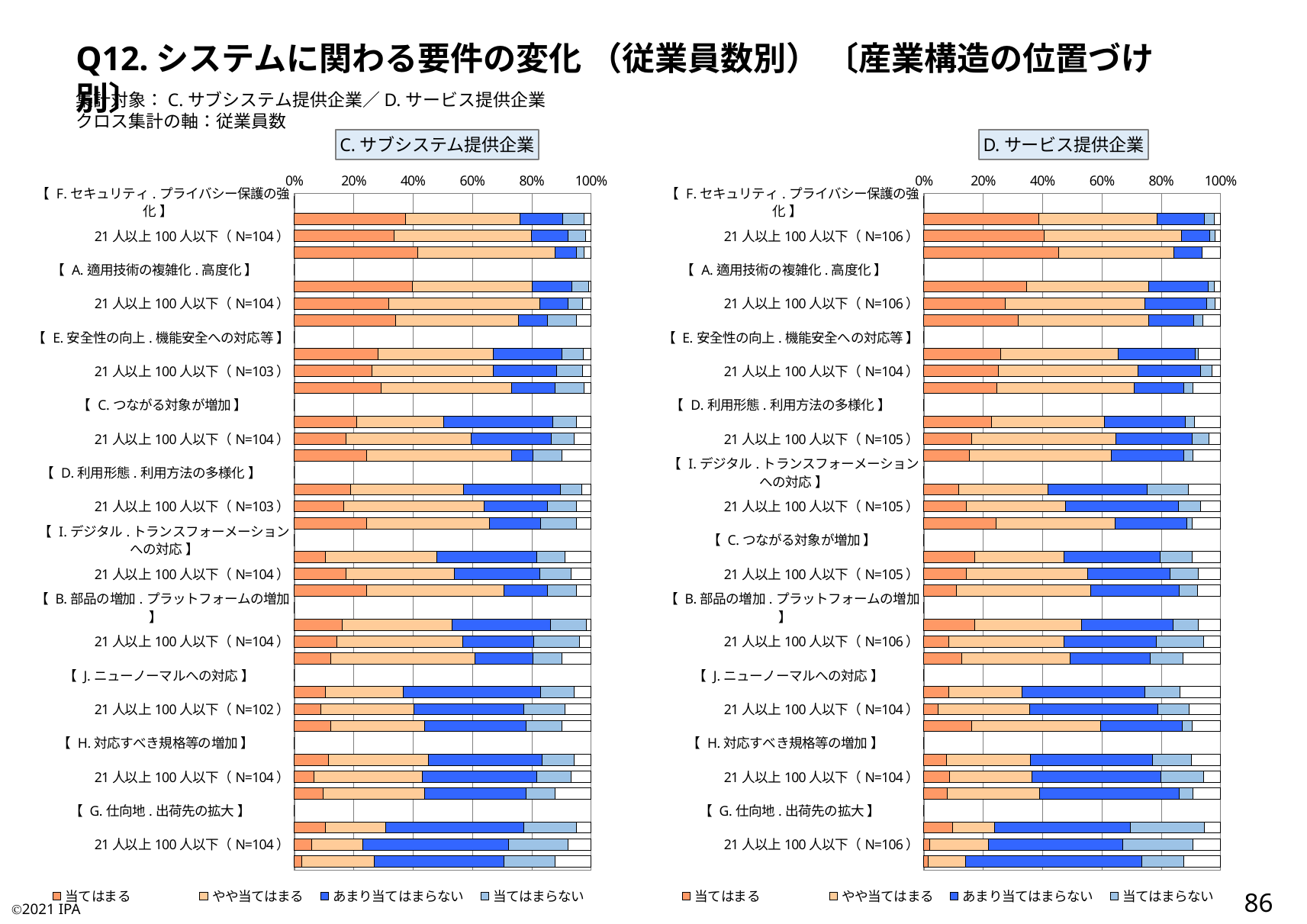
In the left chart (C. サブシステム提供企業), is the 当てはまる share for 21人以上100人以下 (N=104) under A. 適用技術の複雑化.高度化 greater or less than 40%? less In the left chart (C. サブシステム提供企業), is the 当てはまる share for 21人以上100人以下 (N=104) under G. 仕向地.出荷先の拡大 greater or less than 20%? less How many requirement groups (bracketed headings) are listed on the left chart (C. サブシステム提供企業)? 10 In the right chart (D. サービス提供企業), is the 当てはまる share for 21人以上100人以下 (N=104) under H. 対応すべき規格等の増加 greater or less than 20%? less What is the title of the chart on the right side of the slide? D. サービス提供企業 How many entries does the legend of the right chart (D. サービス提供企業) list? 4 What kind of chart is the left chart titled C. サブシステム提供企業? stacked bar chart What is the first legend entry of the left chart (C. サブシステム提供企業)? 当てはまる